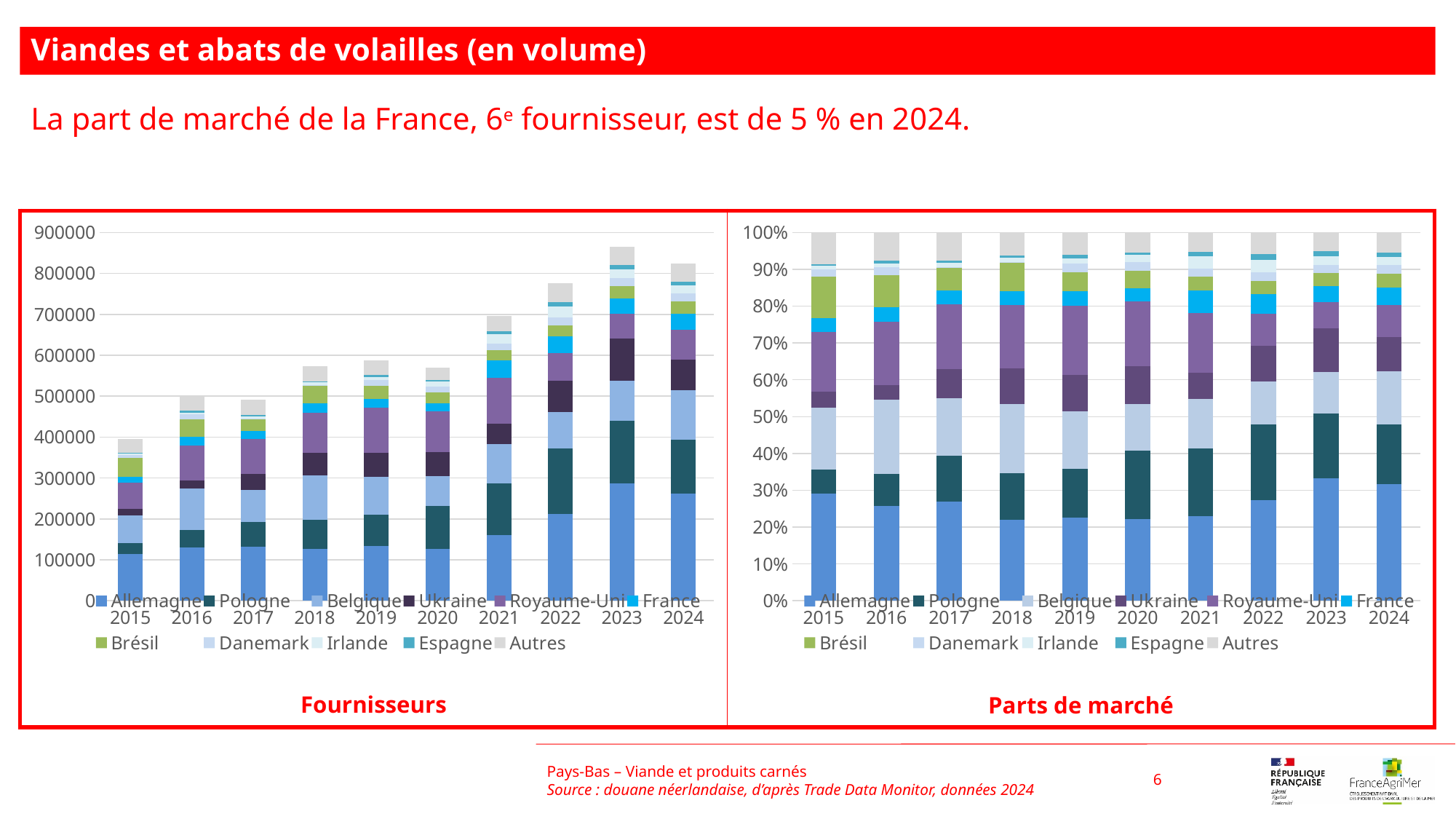
In the 'Fournisseurs' chart, do the total volumes generally rise or fall from 2015 to 2024? rise In the 'Fournisseurs' chart, is the total bar for 2023 greater or less than 800000? greater In the 'Fournisseurs' chart, which total bar is larger, 2023 or 2024? 2023 In the 'Fournisseurs' chart, which year has the shortest total bar? 2015 In the 'Fournisseurs' chart, is the total bar for 2015 greater or less than 500000? less In the 'Parts de marché' chart, is the Allemagne share in 2016 greater or less than 30%? less In the 'Fournisseurs' chart, which year has the tallest total bar? 2023 How many series does the legend of the 'Parts de marché' chart list? 11 How many years are shown on the x axis of the 'Fournisseurs' chart? 10 What is the title of the slide above the two charts? Viandes et abats de volailles (en volume) What kind of chart is the 'Fournisseurs' chart on the left? stacked bar chart In the 'Parts de marché' chart, is the Pologne share larger in 2015 or in 2024? 2024